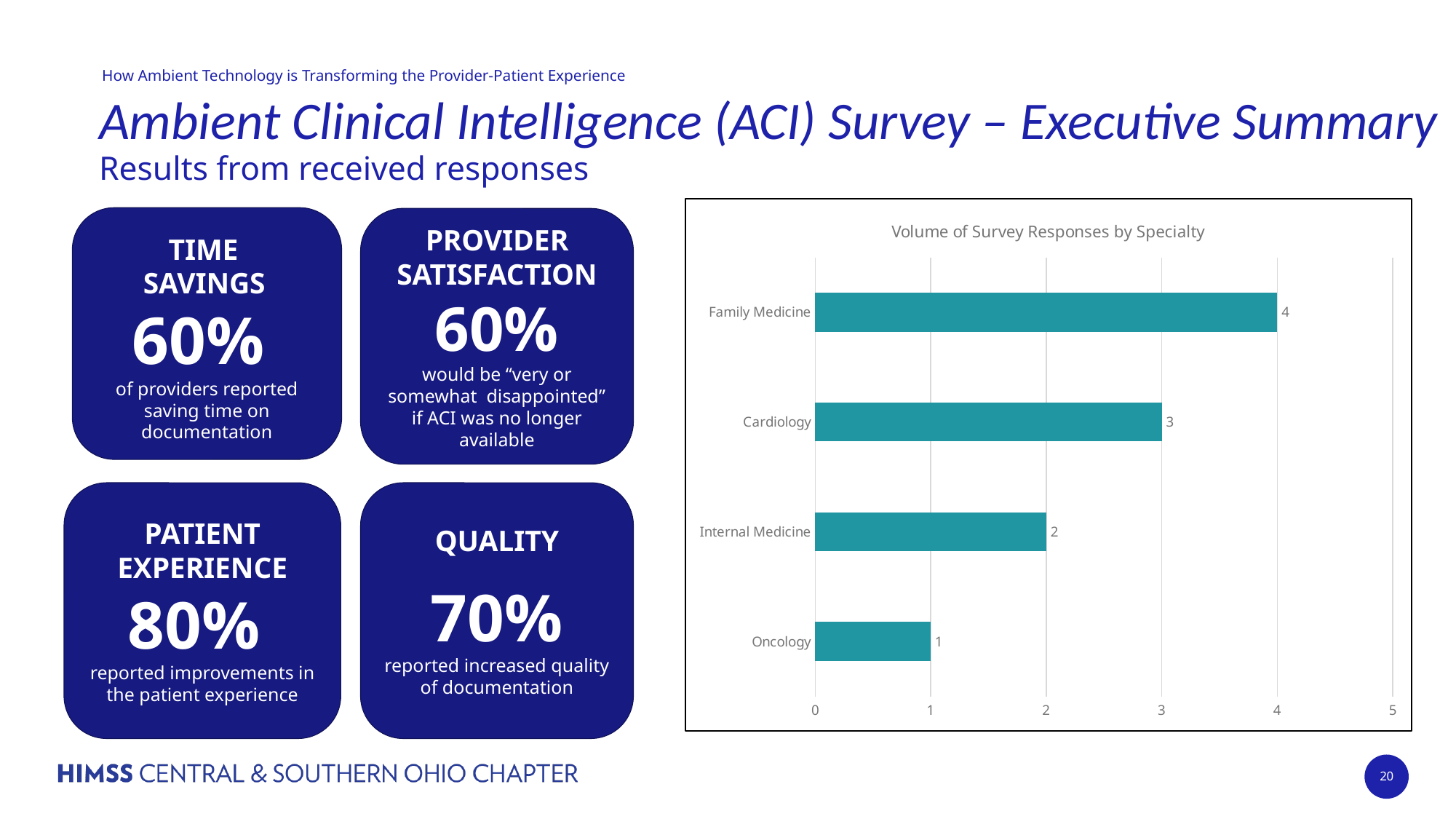
What is the value for Cardiology? 3 Which has more survey responses, Cardiology or Internal Medicine? Cardiology How many specialties are shown in the chart? 4 What kind of chart is shown on the slide? Bar chart What is the difference between the values for Family Medicine and Oncology? 3 What is the value for Internal Medicine? 2 What is the value for Family Medicine? 4 What is the title of the chart? Volume of Survey Responses by Specialty Which specialty has the highest number of survey responses? Family Medicine Which specialty has the lowest number of survey responses? Oncology What is the value for Oncology? 1 What is the total number of survey responses across all four specialties? 10